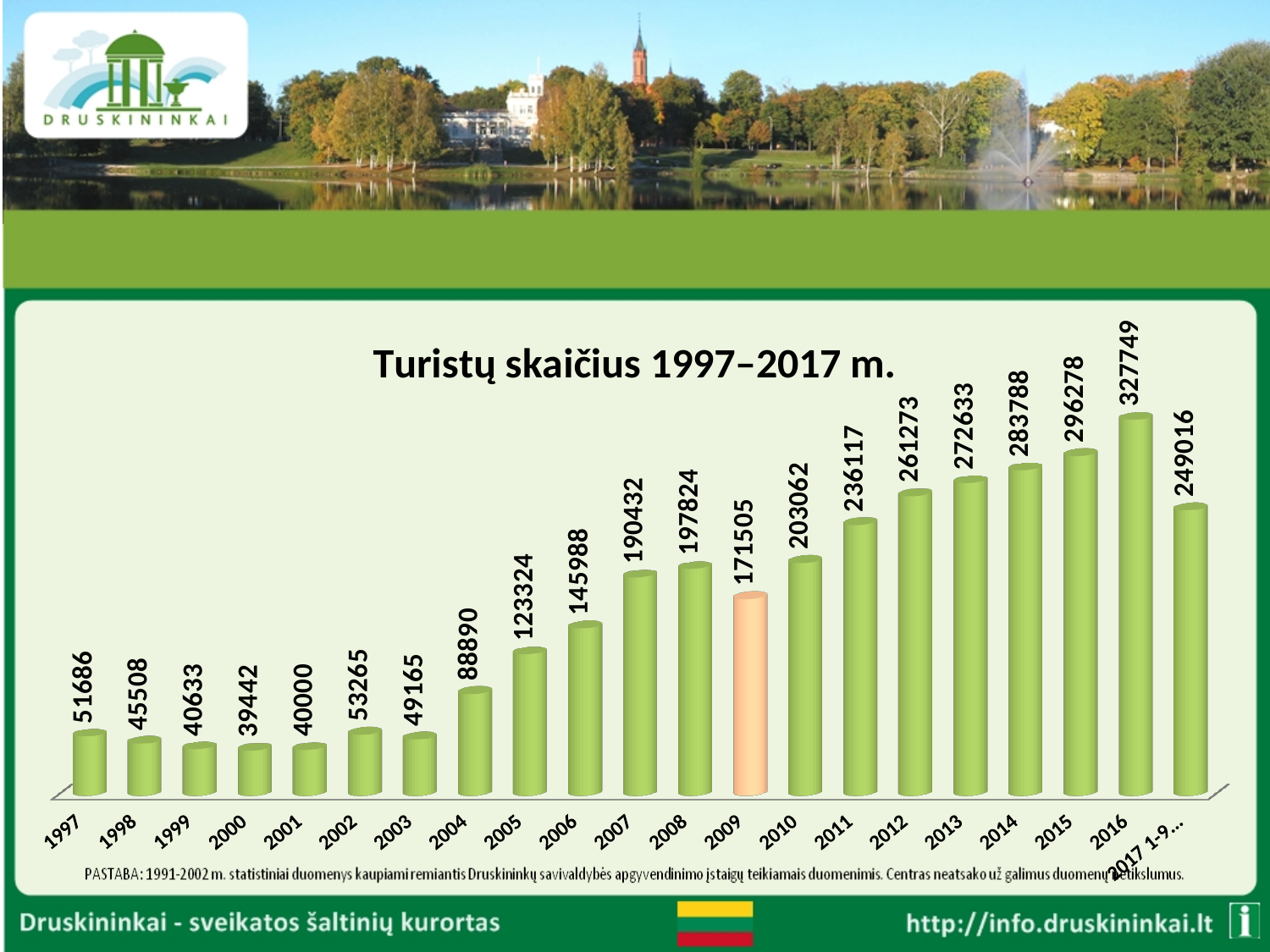
How many bars are shown in the chart? 21 What is the difference between the values for 2016 and 2015? 31471 Which year has the lowest value? 2000 What is the value for 2009? 171505 What is the title of the chart? Turistų skaičius 1997–2017 m. What is the difference between the values for 2008 and 2009? 26319 Which year has the highest value? 2016 What is the value for 2016? 327749 What is the value for 1997? 51686 What type of chart is shown on the slide? bar chart Which is larger, the value for 2009 or the value for 2010? 2010 Which year's bar is shown in a different colour from the others? 2009